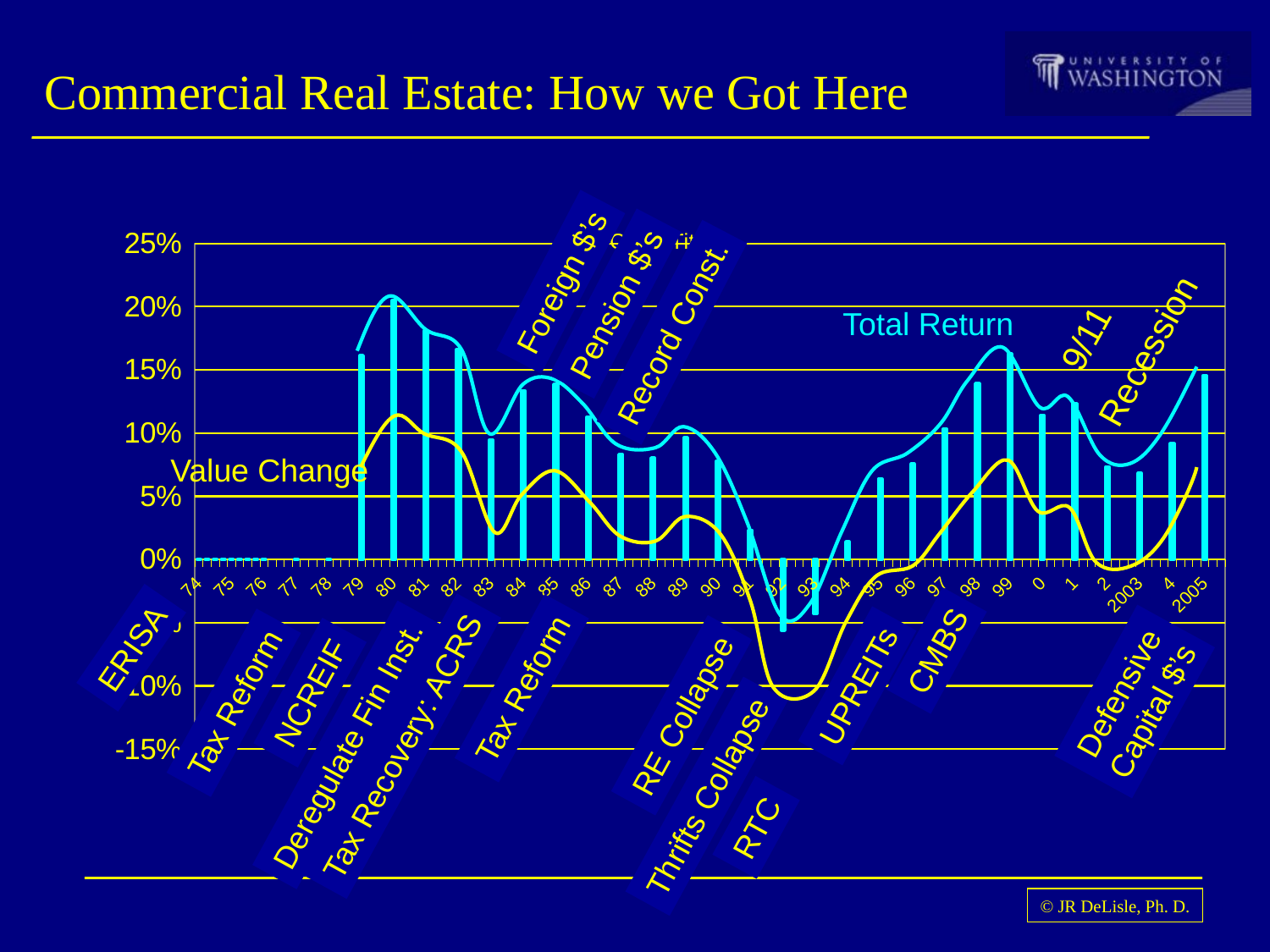
Does the Total Return line rise or fall from 80 to 92? fall Is the bar for 98 greater or less than 10%? greater What kind of chart is shown on the slide? bar and line chart Which bar is taller, 80 or 90? 80 Which year has the tallest bar? 80 Is the Value Change line at 92 greater or less than -5%? less What is the title of the slide containing the chart? Commercial Real Estate: How we Got Here Is the bar for 92 greater or less than 0%? less Which series does the yellow line represent? Value Change